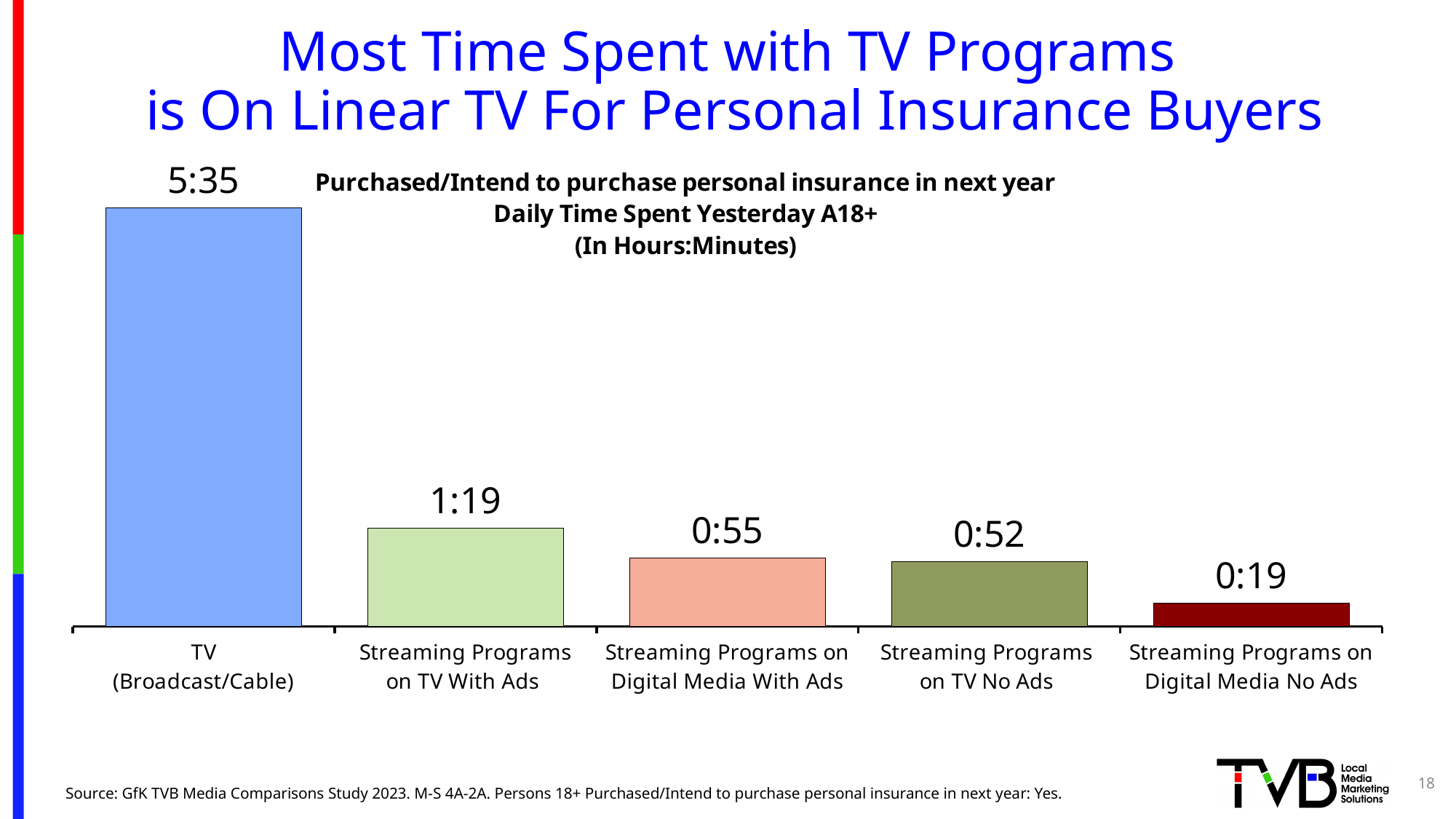
In what units are the values in the chart expressed? Hours:Minutes What type of chart is shown on the slide? Bar chart What is the daily time spent with TV (Broadcast/Cable)? 5:35 How many categories are shown in the chart? 5 What is the daily time spent with Streaming Programs on Digital Media With Ads? 0:55 What is the daily time spent with Streaming Programs on TV With Ads? 1:19 Which category has the lowest daily time spent? Streaming Programs on Digital Media No Ads What is the daily time spent with Streaming Programs on Digital Media No Ads? 0:19 How much more daily time is spent with TV (Broadcast/Cable) than with Streaming Programs on TV With Ads? 4:16 What is the daily time spent with Streaming Programs on TV No Ads? 0:52 Which is larger: daily time spent with Streaming Programs on TV With Ads or Streaming Programs on Digital Media No Ads? Streaming Programs on TV With Ads Which category has the highest daily time spent? TV (Broadcast/Cable)